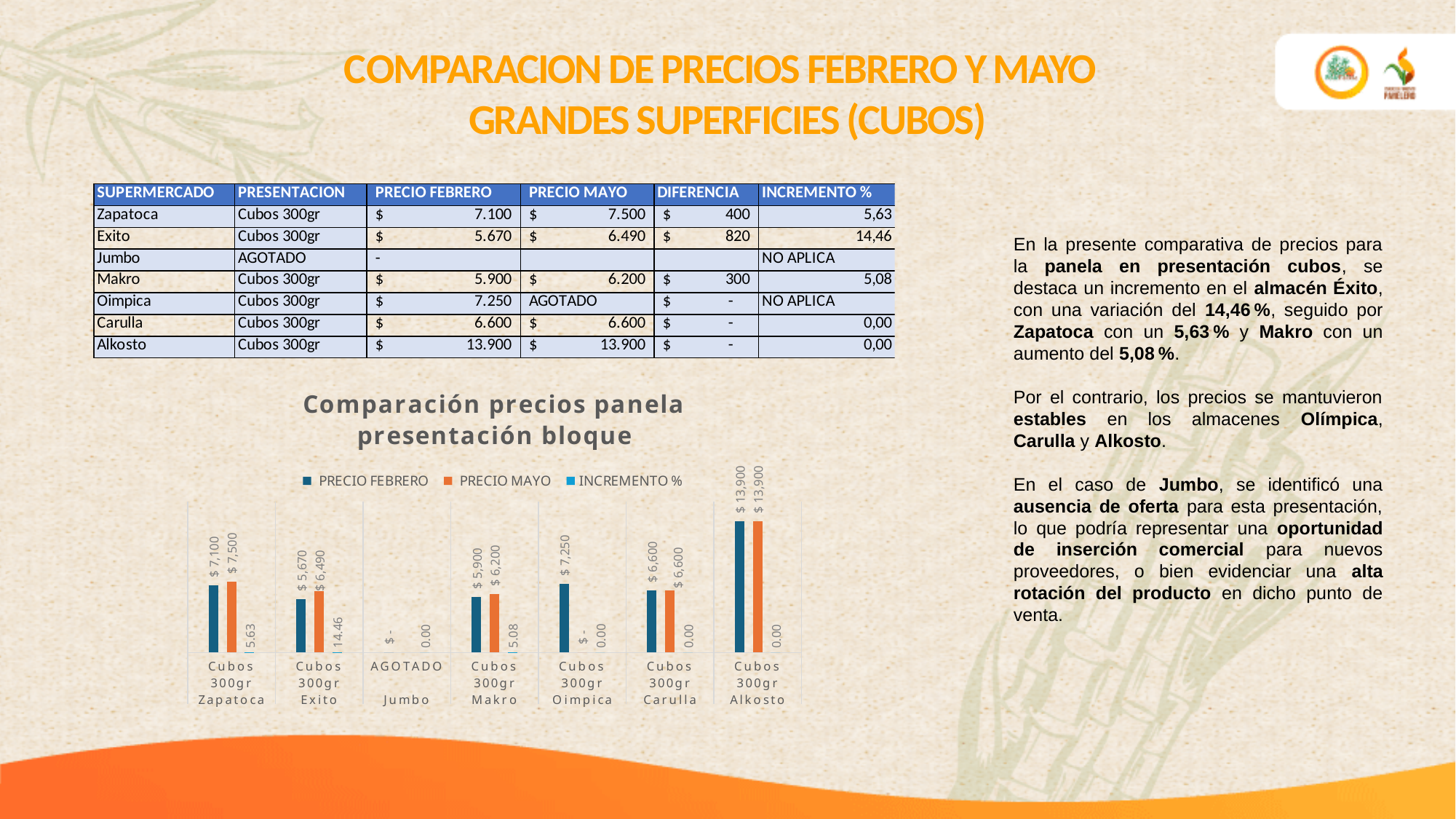
What is the title of the chart? Comparación precios panela presentación bloque How many series does the chart legend list? 3 What is the INCREMENTO % value for Makro in the chart? 5.08 What is the difference between the PRECIO MAYO and PRECIO FEBRERO values for Makro in the chart? $ 300 Which is larger in the chart, the PRECIO FEBRERO for Zapatoca or the PRECIO FEBRERO for Exito? Zapatoca What is the PRECIO MAYO value for Exito in the chart? $ 6,490 Which supermarket has the highest PRECIO MAYO in the chart? Alkosto What is the PRECIO FEBRERO value for Zapatoca in the chart? $ 7,100 How many supermarket categories are shown on the x axis of the chart? 7 What is the PRECIO FEBRERO value for Oimpica in the chart? $ 7,250 What type of chart is shown on the slide? bar chart Which supermarket has the highest INCREMENTO % in the chart? Exito